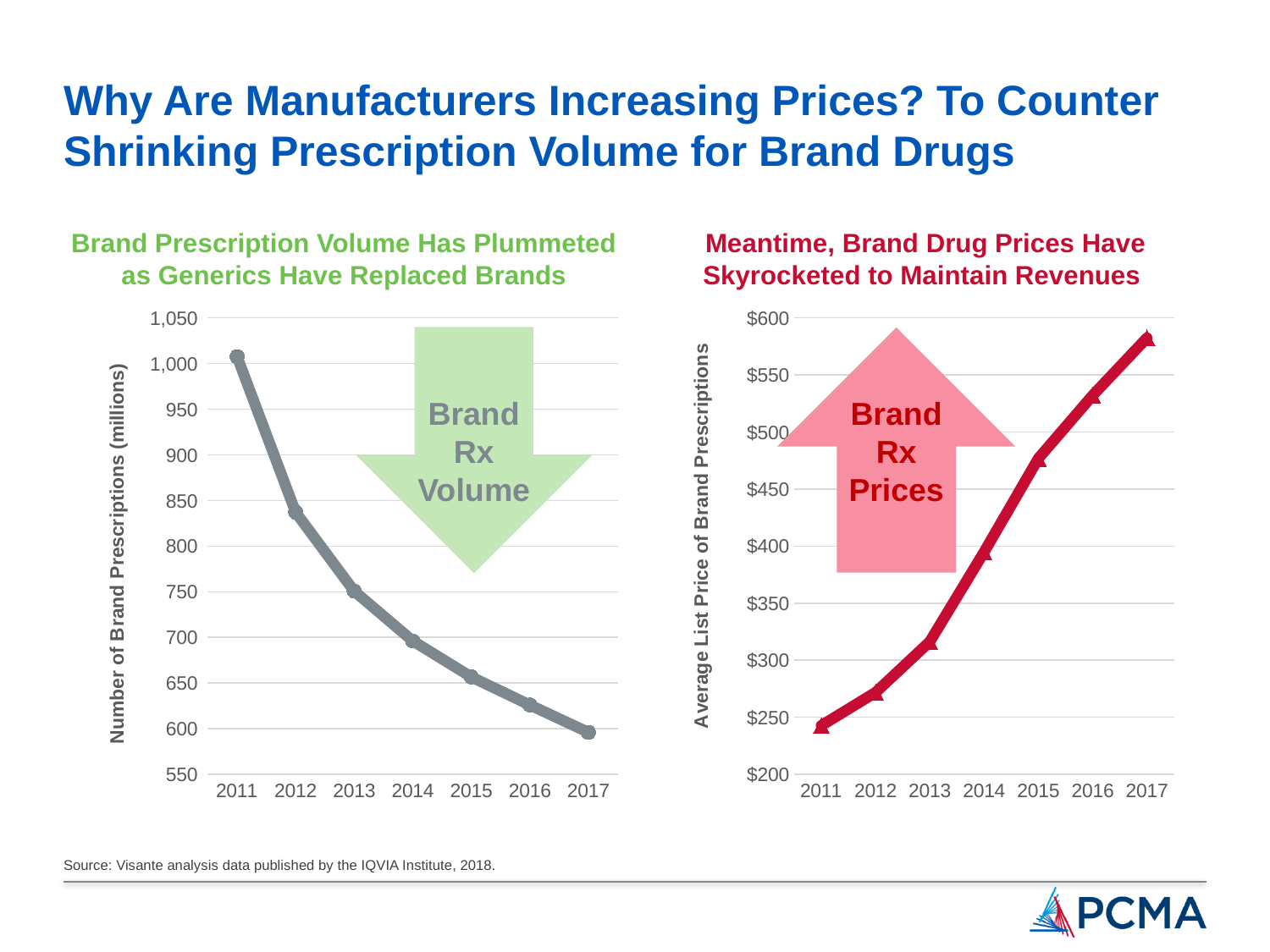
In the left chart on brand prescription volume, is the value for 2012 greater or less than 850? less In the left chart on brand prescription volume, which year has the lowest number of brand prescriptions? 2017 In the left chart on brand prescription volume, is the value for 2013 greater or less than 700? greater In the right chart on brand drug prices, is the value for 2015 greater or less than $450? greater In the right chart on brand drug prices, which year has the highest average list price? 2017 What type of chart is the left chart, 'Brand Prescription Volume Has Plummeted as Generics Have Replaced Brands'? Line chart What is the y-axis label of the right chart on brand drug prices? Average List Price of Brand Prescriptions In the left chart on brand prescription volume, how many years are plotted along the x axis? 7 In the right chart on brand drug prices, do the values rise or fall from 2011 to 2017? Rise In the left chart on brand prescription volume, which year has the highest number of brand prescriptions? 2011 In the left chart on brand prescription volume, do the values rise or fall from 2011 to 2017? Fall